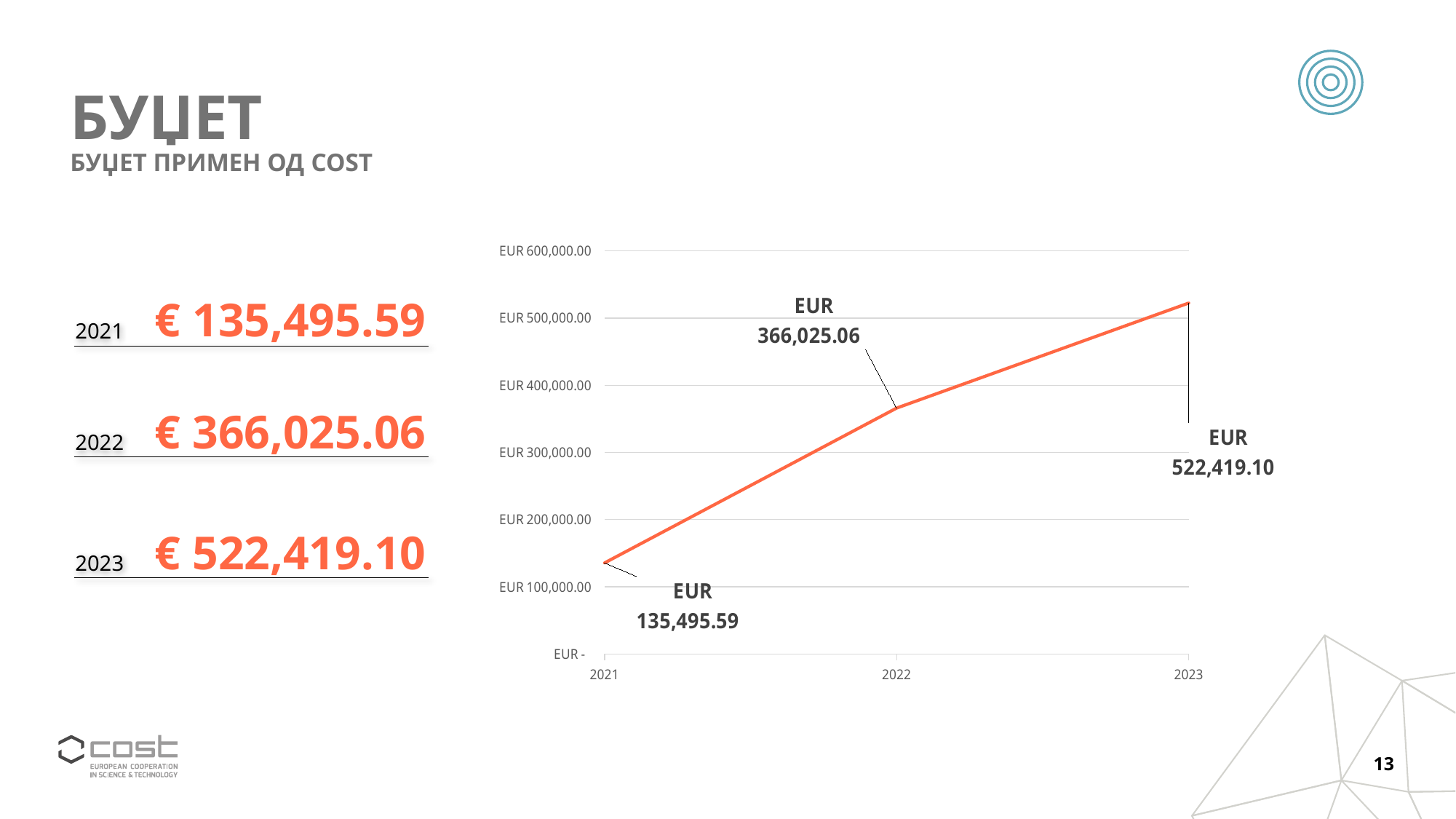
Which is larger, the value for 2022 or the value for 2023? 2023 What is the value plotted for 2023? EUR 522,419.10 How many years are plotted on the chart? 3 What is the value plotted for 2022? EUR 366,025.06 Which year has the highest value on the chart? 2023 What is the difference between the 2022 and 2021 values? EUR 230,529.47 What is the difference between the 2023 and 2022 values? EUR 156,394.04 What kind of chart is shown on the slide? line chart Is the value for 2022 greater or less than EUR 400,000.00? less Do the values rise or fall from 2021 to 2023? rise Which year has the lowest value on the chart? 2021 What is the value plotted for 2021? EUR 135,495.59